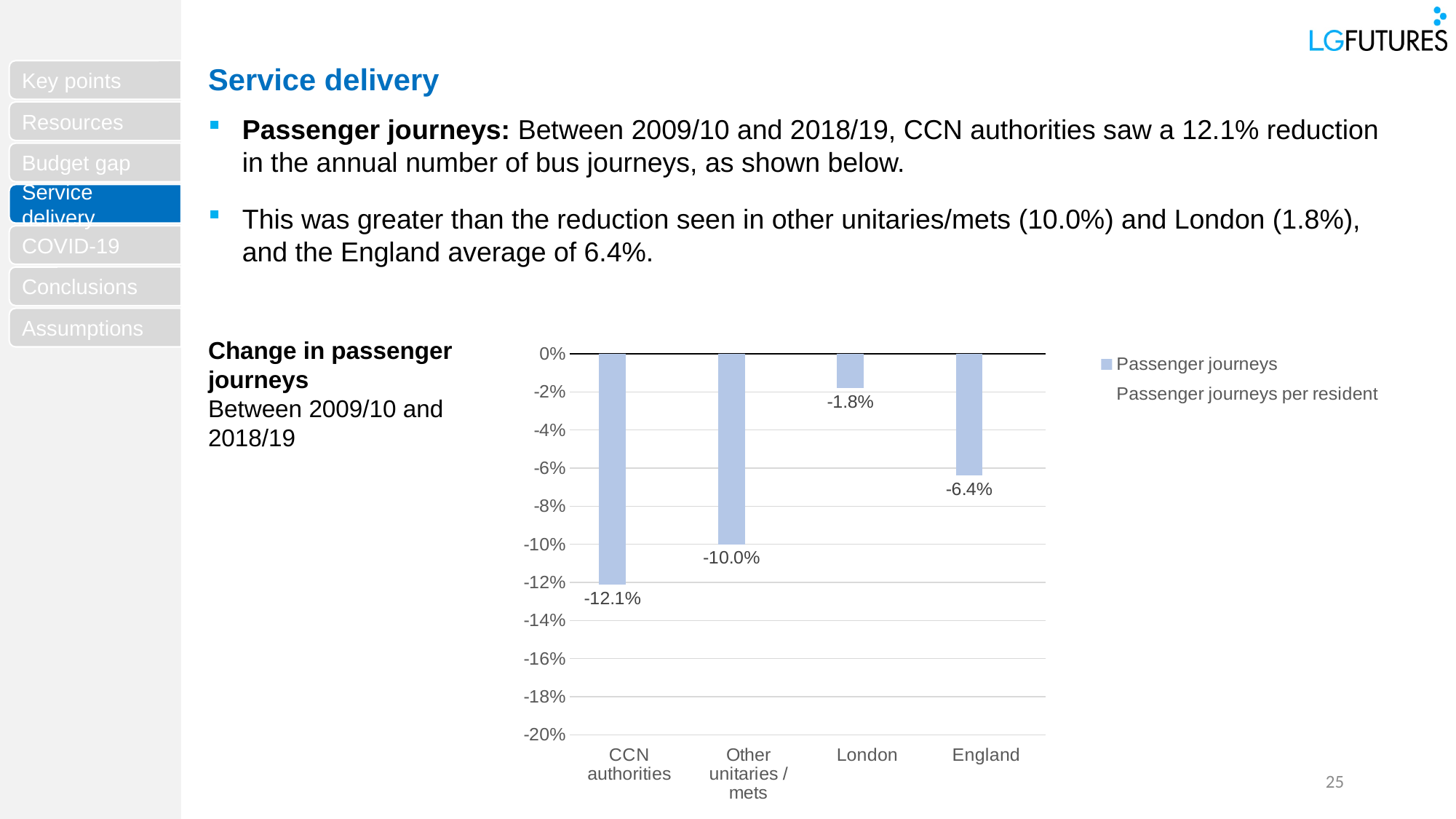
What is the title of the chart on the slide? Change in passenger journeys Between 2009/10 and 2018/19 How many categories are shown on the x axis of the chart? 4 How many entries does the chart's legend list? 2 Which has the larger reduction, Other unitaries / mets or England? Other unitaries / mets Which category shows the smallest reduction (highest value) in the chart? London What is the difference in percentage points between the values for CCN authorities and England? 5.7 percentage points What is the value for CCN authorities in the chart? -12.1% What is the value for London in the chart? -1.8% What is the value for England in the chart? -6.4% What is the value for Other unitaries / mets in the chart? -10.0% Which category shows the largest reduction (lowest value) in the chart? CCN authorities What kind of chart is shown on the slide? Bar chart